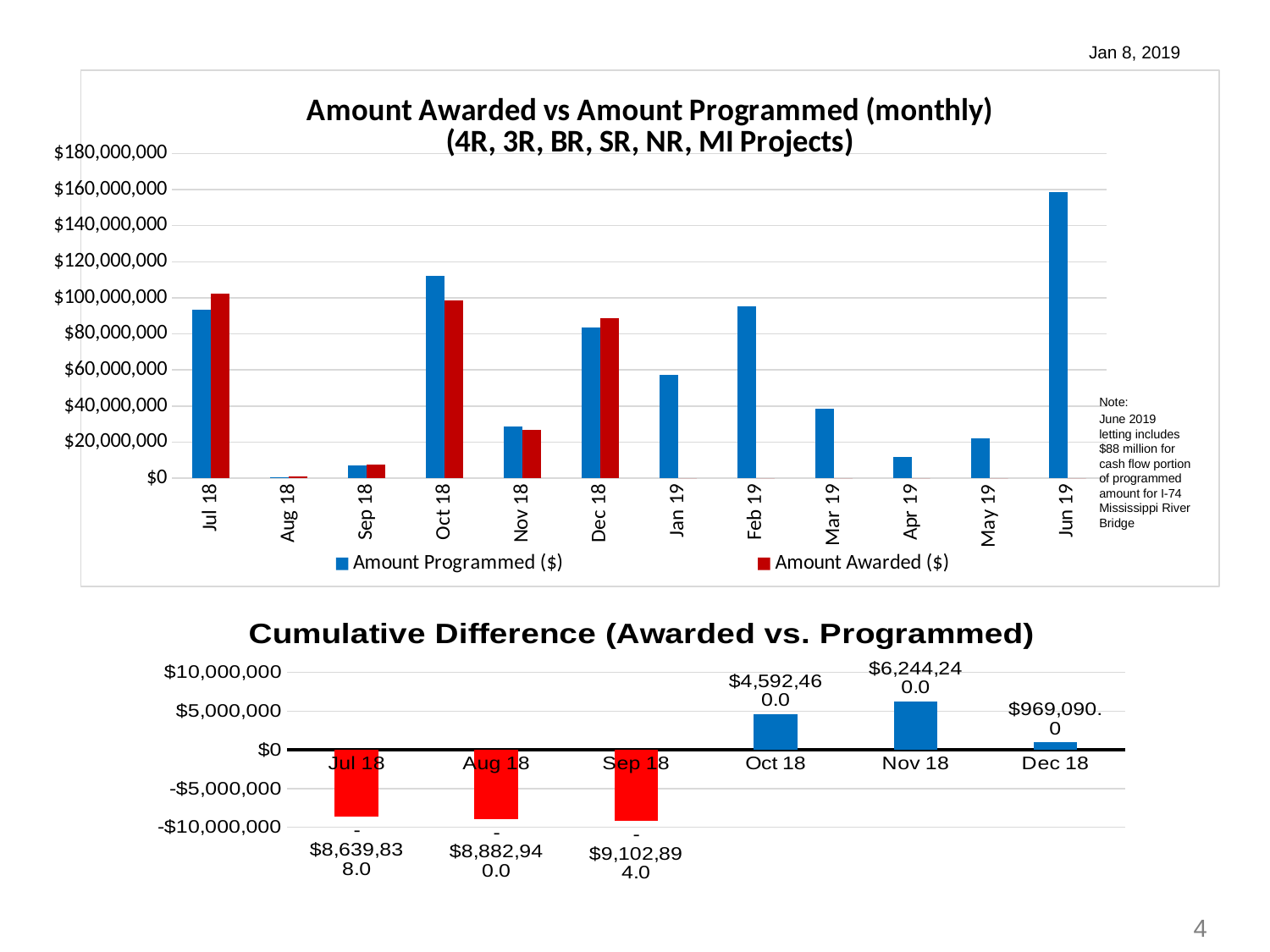
In the top chart, Amount Awarded vs Amount Programmed (monthly), is the Amount Programmed ($) for Jun 19 greater or less than $140,000,000? greater In the top chart, Amount Awarded vs Amount Programmed (monthly), for Jul 18, which is larger: Amount Programmed ($) or Amount Awarded ($)? Amount Awarded ($) In the bottom chart, Cumulative Difference (Awarded vs. Programmed), what is the difference between the Nov 18 and Oct 18 values? $1,651,780.0 In the top chart, Amount Awarded vs Amount Programmed (monthly), how many months are shown on the x axis? 12 What type of chart is the bottom chart, Cumulative Difference (Awarded vs. Programmed)? Bar chart In the top chart, Amount Awarded vs Amount Programmed (monthly), is the Amount Programmed ($) for Oct 18 greater or less than $100,000,000? greater In the bottom chart, Cumulative Difference (Awarded vs. Programmed), which month has the highest value? Nov 18 In the bottom chart, Cumulative Difference (Awarded vs. Programmed), what is the value for Sep 18? -$9,102,894.0 In the bottom chart, Cumulative Difference (Awarded vs. Programmed), which month has the lowest value? Sep 18 In the bottom chart, Cumulative Difference (Awarded vs. Programmed), what is the value for Oct 18? $4,592,460.0 In the top chart, Amount Awarded vs Amount Programmed (monthly), which month has the highest Amount Programmed ($)? Jun 19 In the top chart, Amount Awarded vs Amount Programmed (monthly), how many series does the legend list? 2